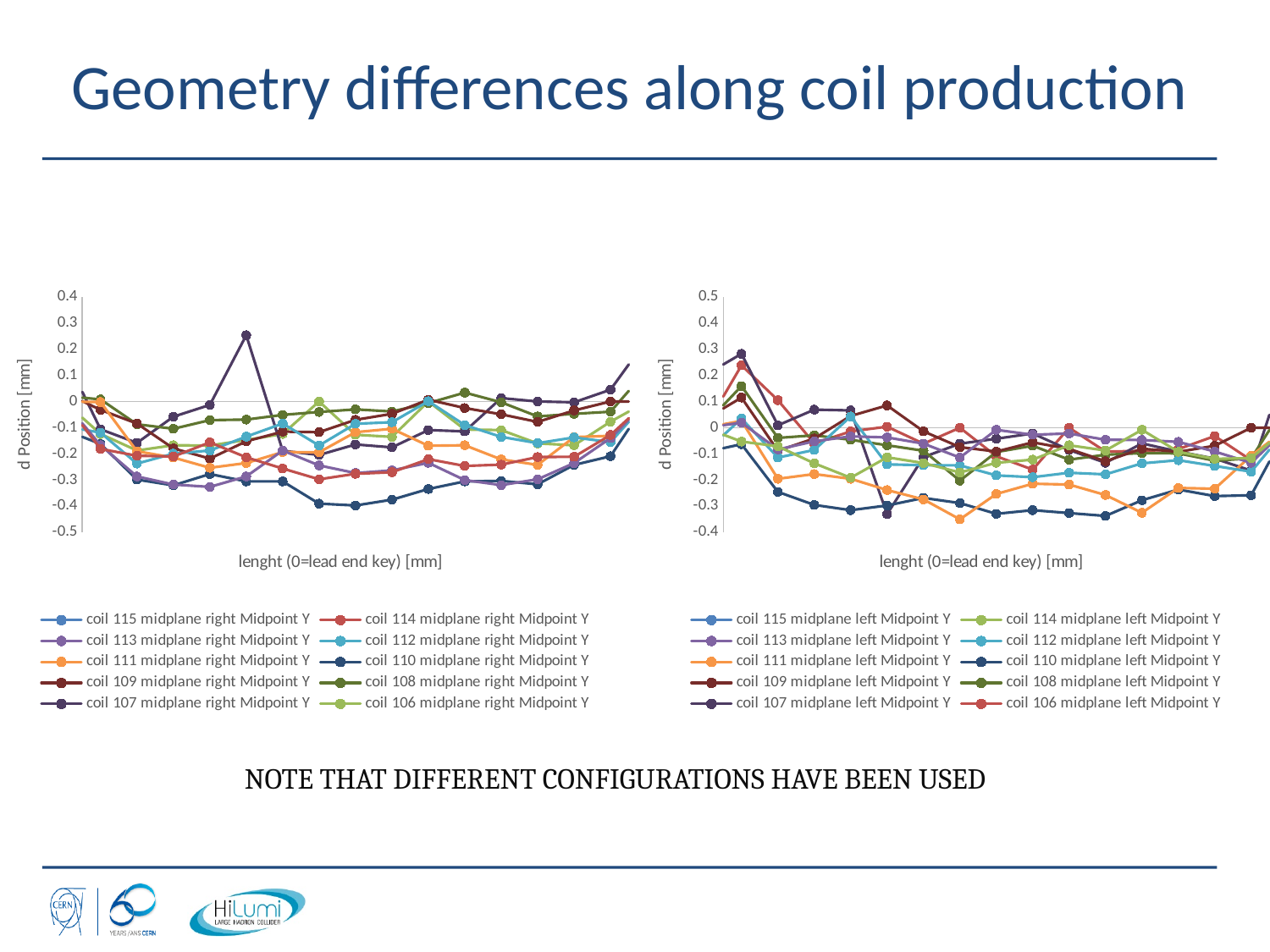
What is the y-axis title of the left chart? d Position [mm] On the left chart, is the peak value of coil 107 midplane right Midpoint Y greater or less than 0.2? greater What kind of chart is the left chart on the slide? line chart On the right chart, is the first value of coil 107 midplane left Midpoint Y greater or less than 0.2? greater On the left chart, which series reaches the lowest value? coil 110 midplane right Midpoint Y How many series does the legend of the left chart list? 10 What kind of chart is the right chart on the slide? line chart How many series does the legend of the right chart list? 10 On the left chart, which series reaches the highest value? coil 107 midplane right Midpoint Y What is the x-axis title of the right chart? lenght (0=lead end key) [mm] On the left chart, is the lowest value of coil 110 midplane right Midpoint Y greater or less than -0.3? less